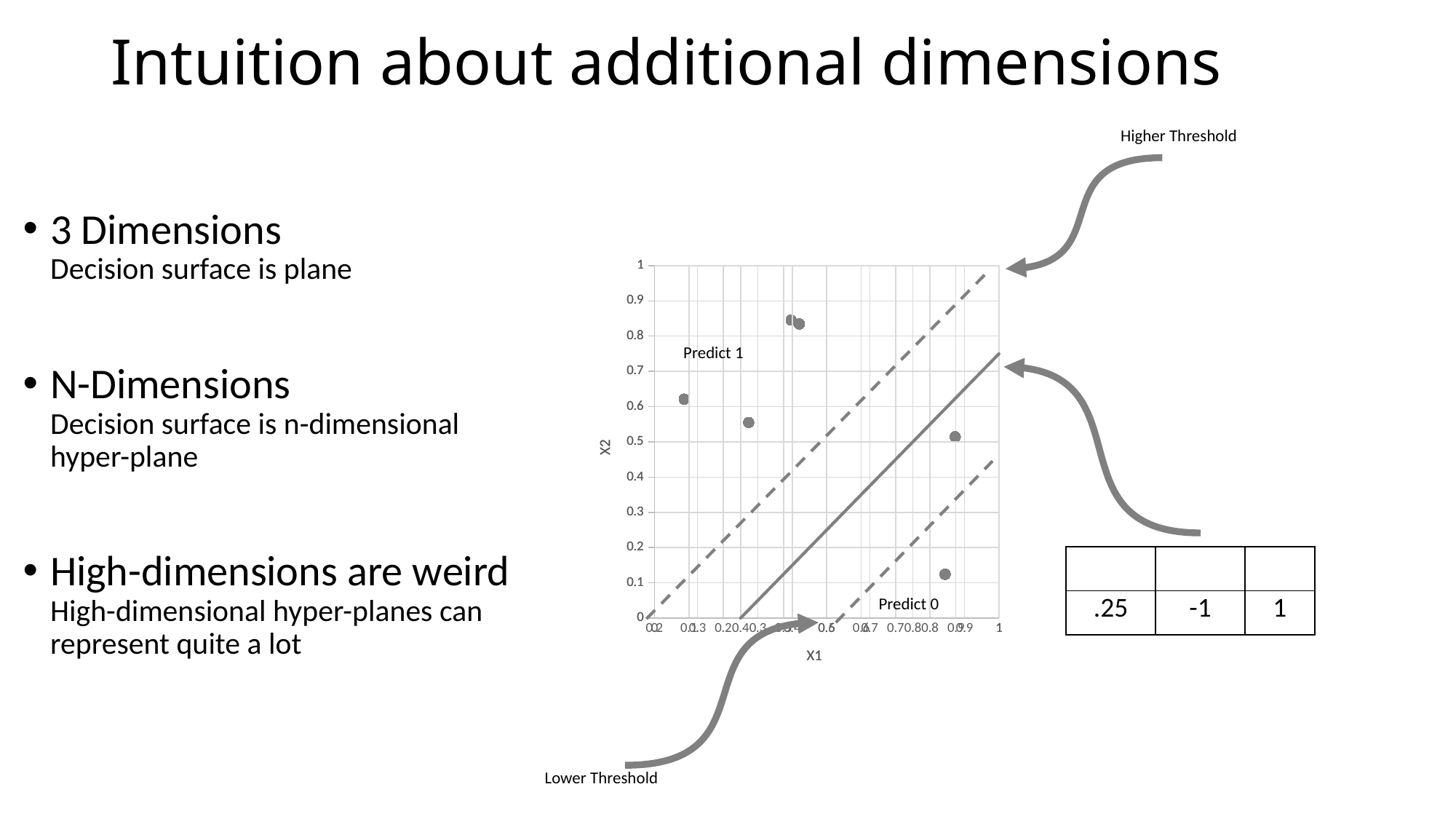
How many dashed threshold lines are drawn on the chart? 2 Are the X2 values of the two highest plotted points greater or less than 0.8? greater What is the label on the horizontal axis of the chart? X1 What is the label on the vertical axis of the chart? X2 Is the X1 value of the lowest plotted point greater or less than 0.7? greater Is the X2 value of the lowest plotted point greater or less than 0.2? less Which region label appears in the upper-left part of the chart, above the solid decision line? Predict 1 What kind of chart is shown on the slide? scatter chart What is the highest tick value shown on the vertical (X2) axis of the chart? 1